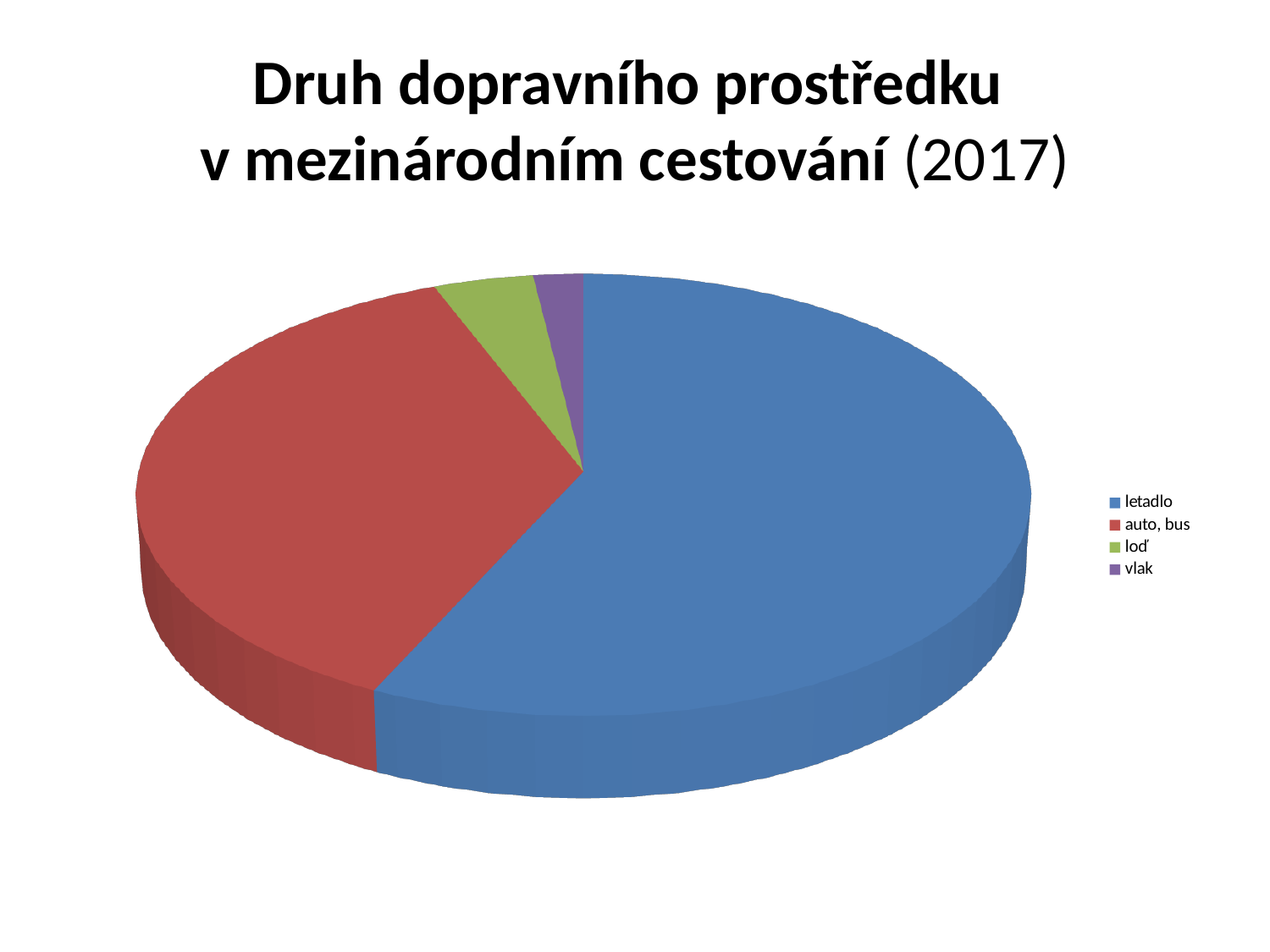
What kind of chart is shown on the slide? pie chart Which slice is larger, letadlo or auto, bus? letadlo How many categories does the pie chart show? 4 Which slice is larger, auto, bus or loď? auto, bus Which slice is larger, loď or vlak? loď What colour is the slice for letadlo? blue What is the title of the chart? Druh dopravního prostředku v mezinárodním cestování (2017) Which category has the smallest slice of the pie? vlak Which category has the second largest slice of the pie? auto, bus How many entries does the legend list? 4 Which category has the largest slice of the pie? letadlo